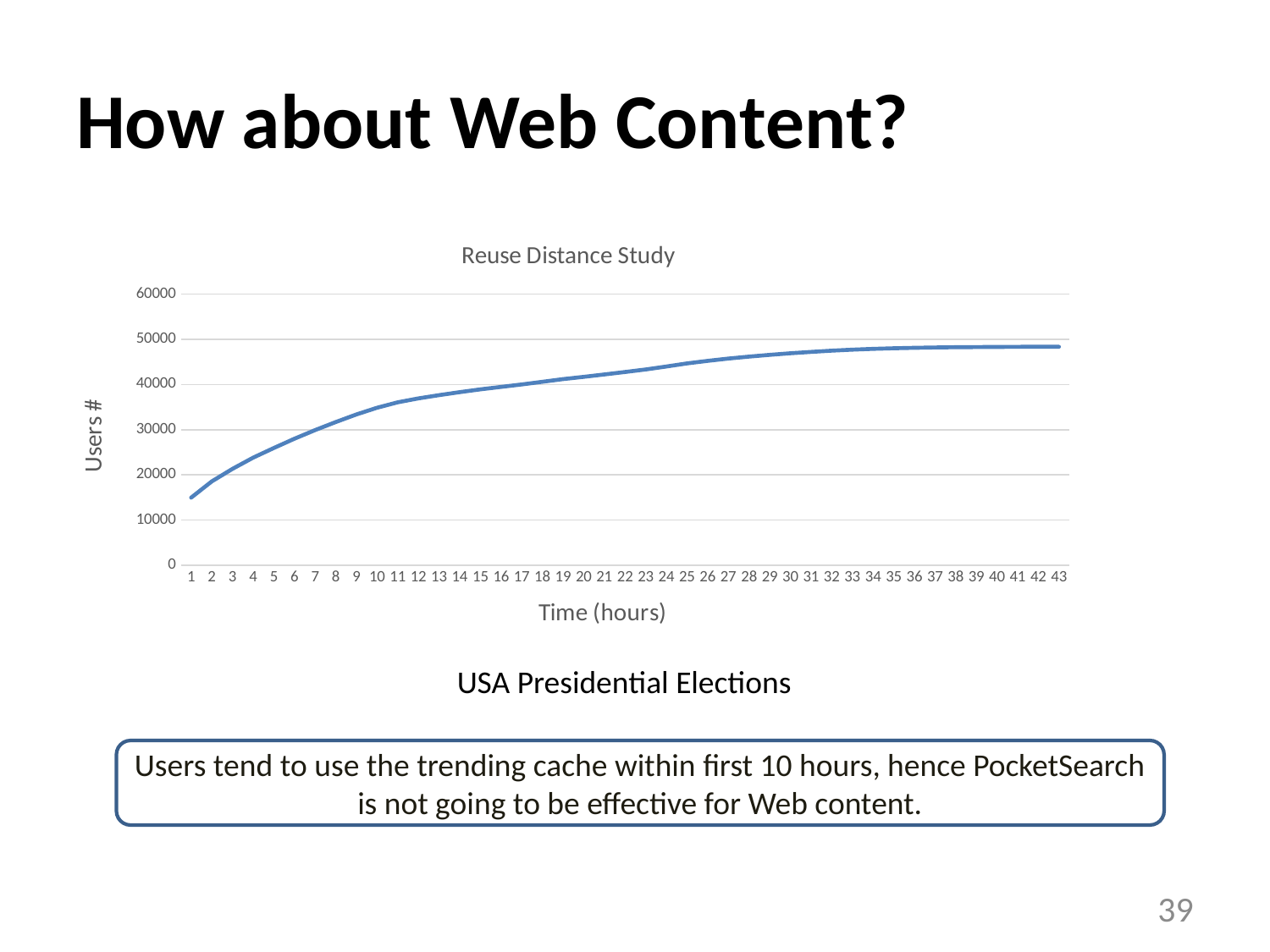
Is the value for hour 1 greater or less than 20000? less How many time points are plotted along the x axis? 43 Is the value for hour 10 greater or less than 30000? greater Is the value for hour 20 greater or less than 40000? greater What is the label of the x axis of the chart? Time (hours) At which hour is the number of users highest? 43 Which has more users, hour 5 or hour 30? hour 30 What kind of chart is shown on the slide? line chart What is the title of the chart? Reuse Distance Study At which hour is the number of users lowest? 1 Do the values rise or fall as time increases along the x axis? rise